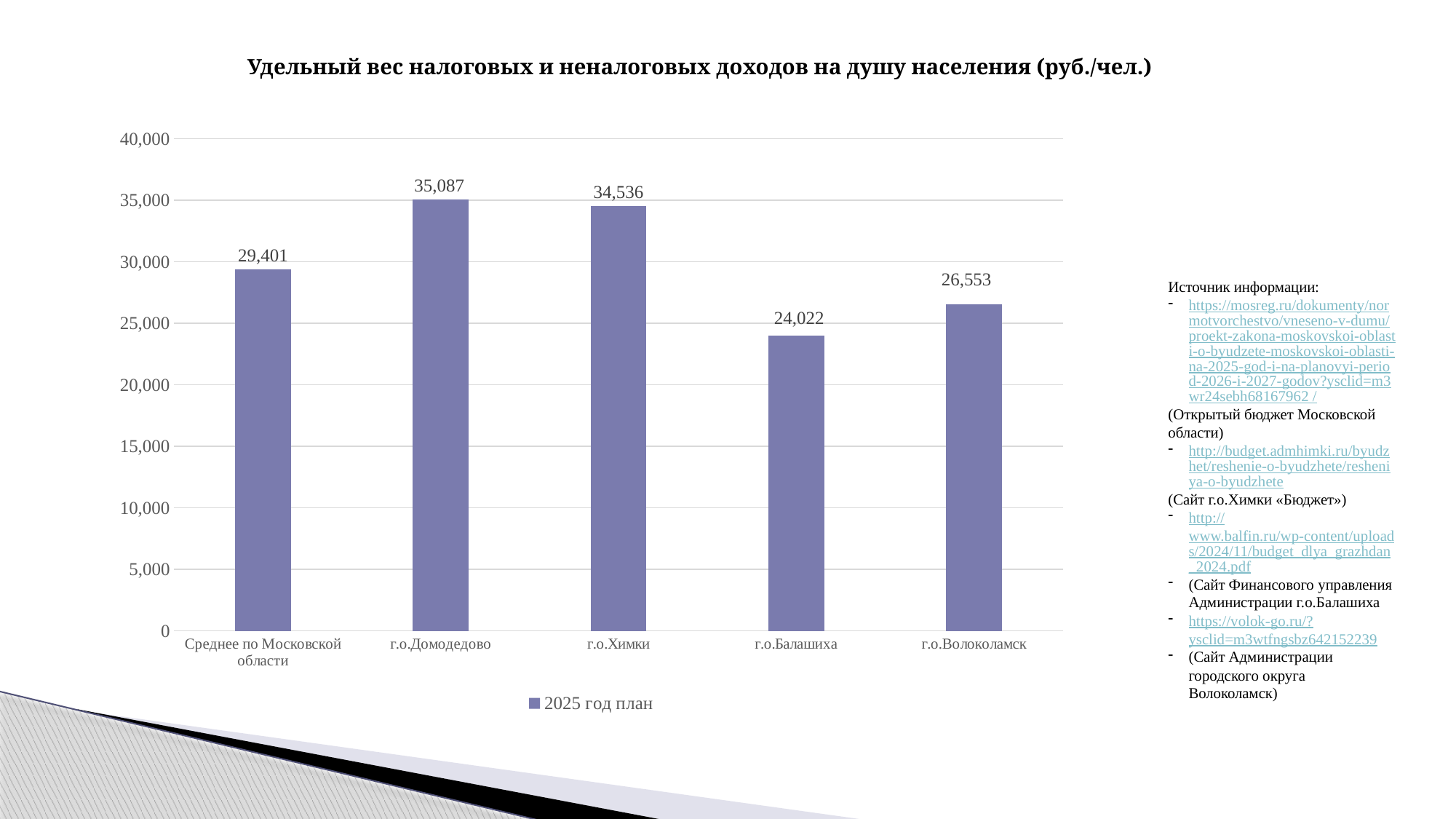
What is the value for г.о.Балашиха? 24,022 What kind of chart is shown on the slide? bar chart What is the value for г.о.Домодедово? 35,087 What is the value for Среднее по Московской области? 29,401 Which is larger, the value for г.о.Химки or the value for Среднее по Московской области? г.о.Химки Which category has the highest value? г.о.Домодедово What is the difference between the values for г.о.Домодедово and г.о.Химки? 551 Which category has the lowest value? г.о.Балашиха How many categories are shown on the x axis? 5 What is the difference between the values for г.о.Волоколамск and г.о.Балашиха? 2,531 Is the value for г.о.Волоколамск greater or less than 25,000? greater What series does the legend list? 2025 год план